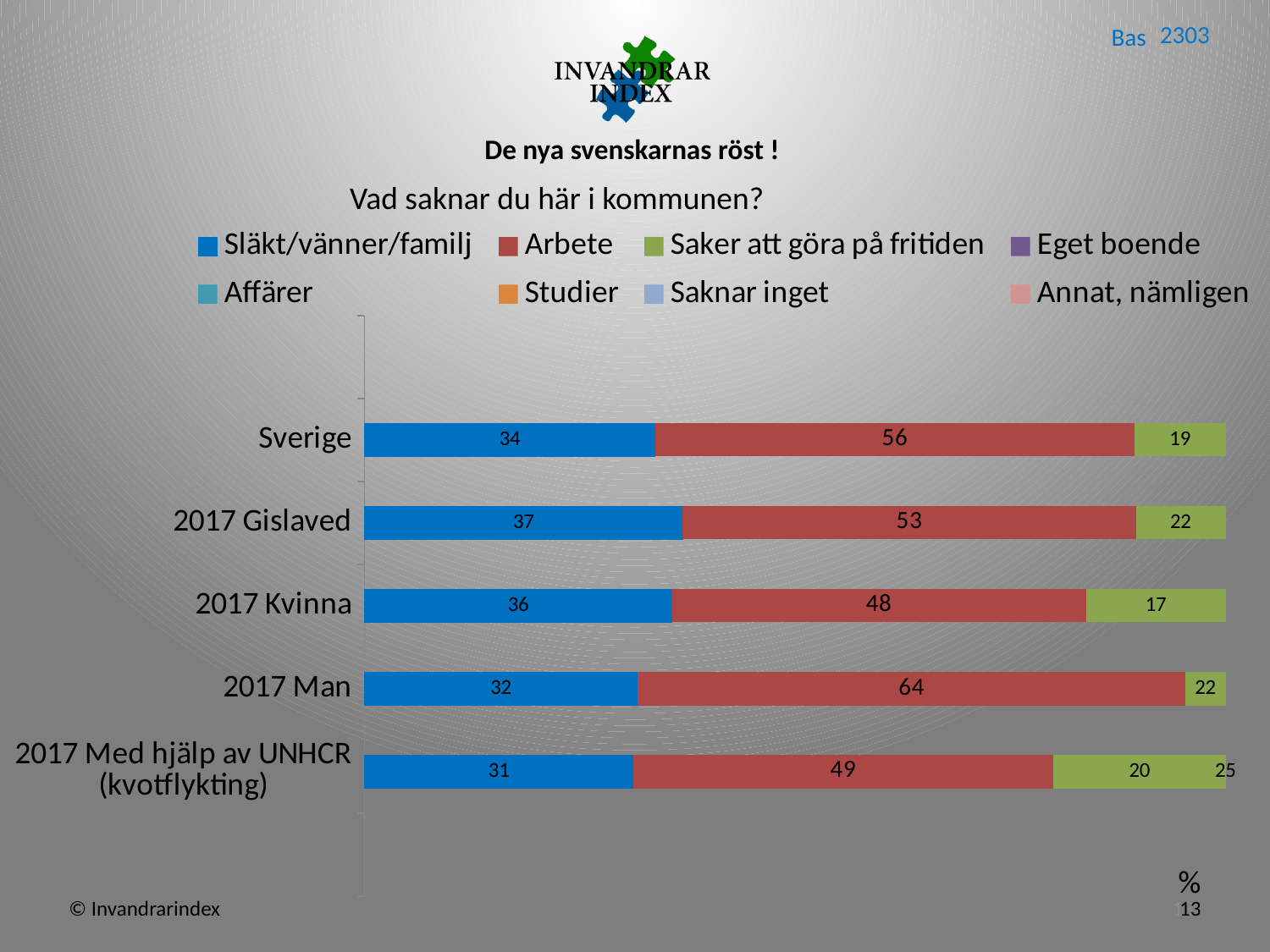
Which category has the highest value for Arbete? 2017 Man What is the title of the chart? Vad saknar du här i kommunen? What is the value for Arbete in the 2017 Med hjälp av UNHCR (kvotflykting) category? 49 How many series does the legend list? 8 How many categories are shown on the vertical axis? 5 Which category has the lowest value for Släkt/vänner/familj? 2017 Med hjälp av UNHCR (kvotflykting) Which is larger: the Släkt/vänner/familj value for 2017 Gislaved or for 2017 Man? 2017 Gislaved What is the value for Släkt/vänner/familj in the Sverige category? 34 What is the value for Saker att göra på fritiden in the 2017 Kvinna category? 17 What is the difference between the Arbete values for 2017 Man and 2017 Kvinna? 16 What is the value for Arbete in the 2017 Man category? 64 What type of chart is shown on the slide? Stacked bar chart